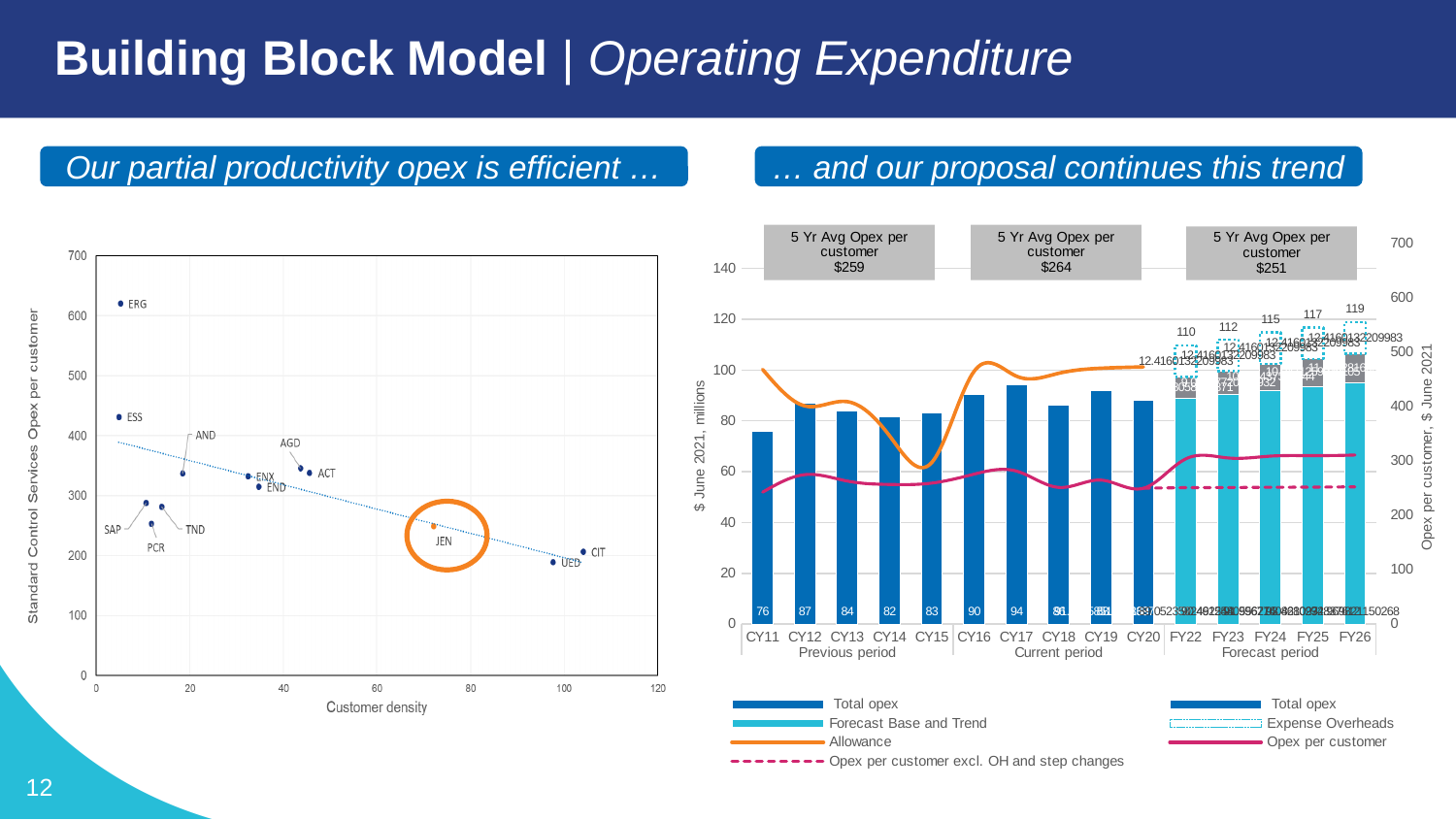
On the right chart, do the total opex values rise or fall from FY22 to FY26? rise What kind of chart is the left chart, 'Our partial productivity opex is efficient …'? scatter chart On the right chart, which is larger, the total opex for CY12 or CY13? CY12 On the left chart, which entity has the highest Standard Control Services Opex per customer? ERG On the left chart, is the opex per customer for ERG greater or less than 600? greater On the right chart, '… and our proposal continues this trend', what is the total opex for CY11? 76 On the right chart, what is the total opex for FY26? 119 On the left chart, is the opex per customer for JEN greater or less than 300? less On the left chart, how many labelled data points are plotted? 13 On the right chart, what is the difference between the total opex for FY26 and FY22? 9 On the right chart, what is the 5 Yr Avg Opex per customer shown for the Forecast period? $251 On the right chart, what is the label of the left vertical axis? $ June 2021, millions